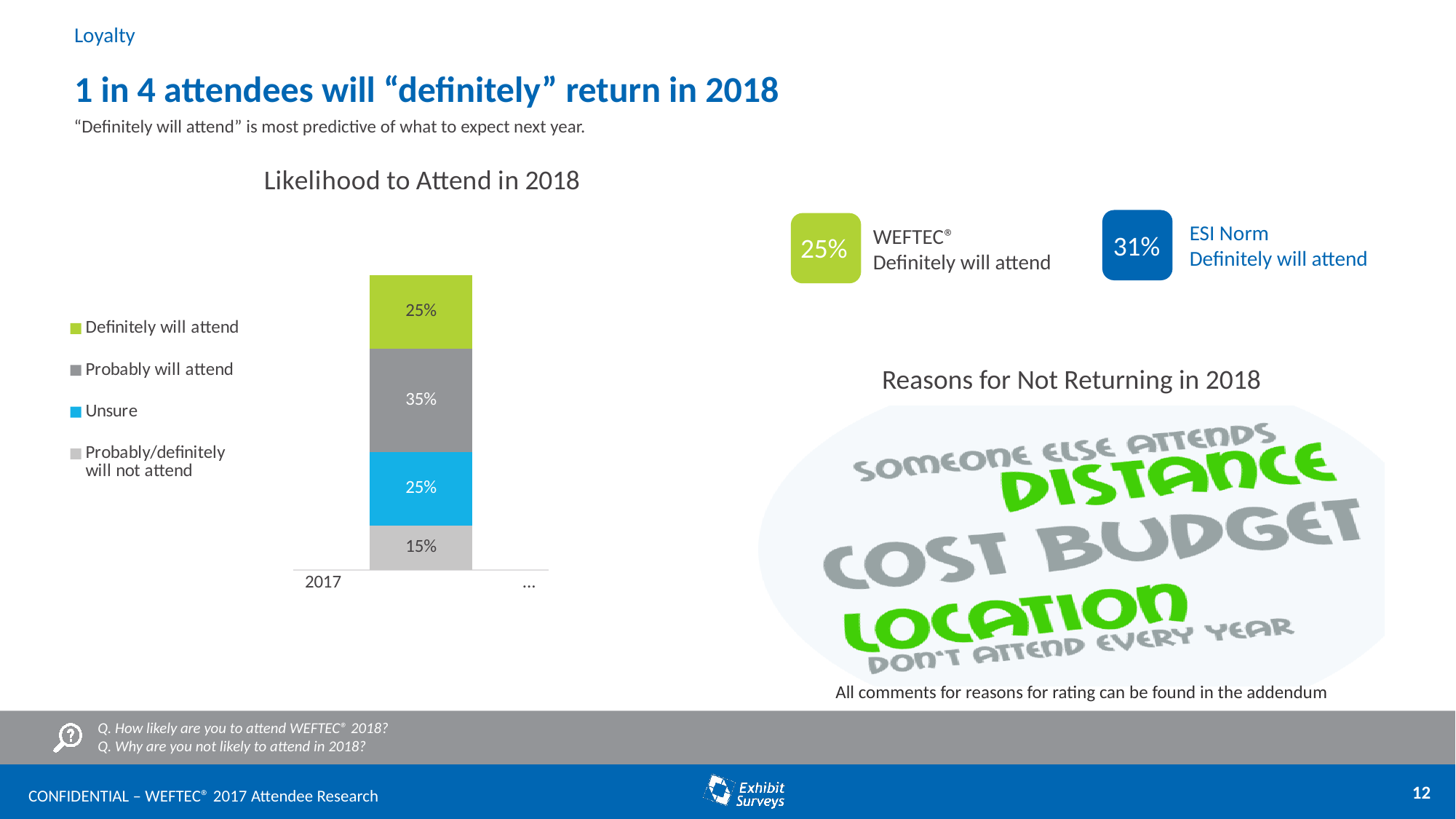
In the Likelihood to Attend in 2018 chart, which response category has the largest share? Probably will attend How many series does the legend of the Likelihood to Attend in 2018 chart list? 4 In the Likelihood to Attend in 2018 chart, what percentage of 2017 attendees say they definitely will attend? 25% In the Likelihood to Attend in 2018 chart, which is larger: Unsure or Probably/definitely will not attend? Unsure In the Likelihood to Attend in 2018 chart, which colour represents Unsure? Blue In the Likelihood to Attend in 2018 chart, which response category has the smallest share? Probably/definitely will not attend In the Likelihood to Attend in 2018 chart, what is the value for Probably will attend? 35% What kind of chart is the Likelihood to Attend in 2018 chart? Stacked bar chart In the Likelihood to Attend in 2018 chart, what is the value for Unsure? 25% In the Likelihood to Attend in 2018 chart, what is the total of the 2017 stacked bar? 100% In the Likelihood to Attend in 2018 chart, what is the value for Probably/definitely will not attend? 15% In the Likelihood to Attend in 2018 chart, what is the difference between Probably will attend and Definitely will attend? 10%